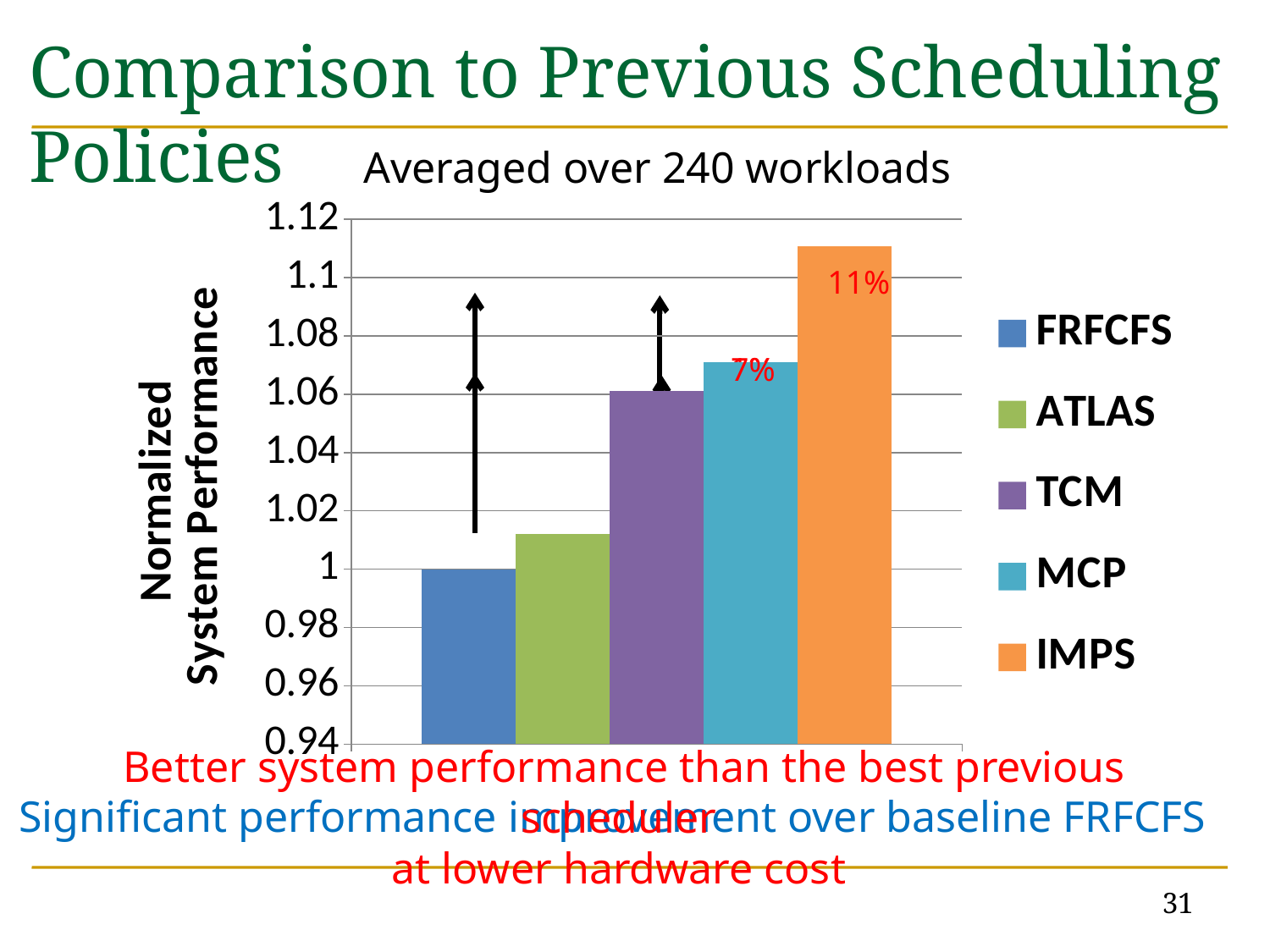
Do the bar values rise or fall from left to right across the chart? rise Which scheduling policy has the highest normalized system performance? IMPS Which has a higher normalized system performance, ATLAS or TCM? TCM Which scheduling policy has the lowest normalized system performance? FRFCFS What is the title shown above the chart? Averaged over 240 workloads How many series does the legend list? 5 Is the value for ATLAS greater or less than 1.02? less Is the value for TCM greater or less than 1.04? greater How many bars are plotted in the chart? 5 Is the value for IMPS greater or less than 1.1? greater What kind of chart is shown on the slide? bar chart What is the normalized system performance value for FRFCFS? 1